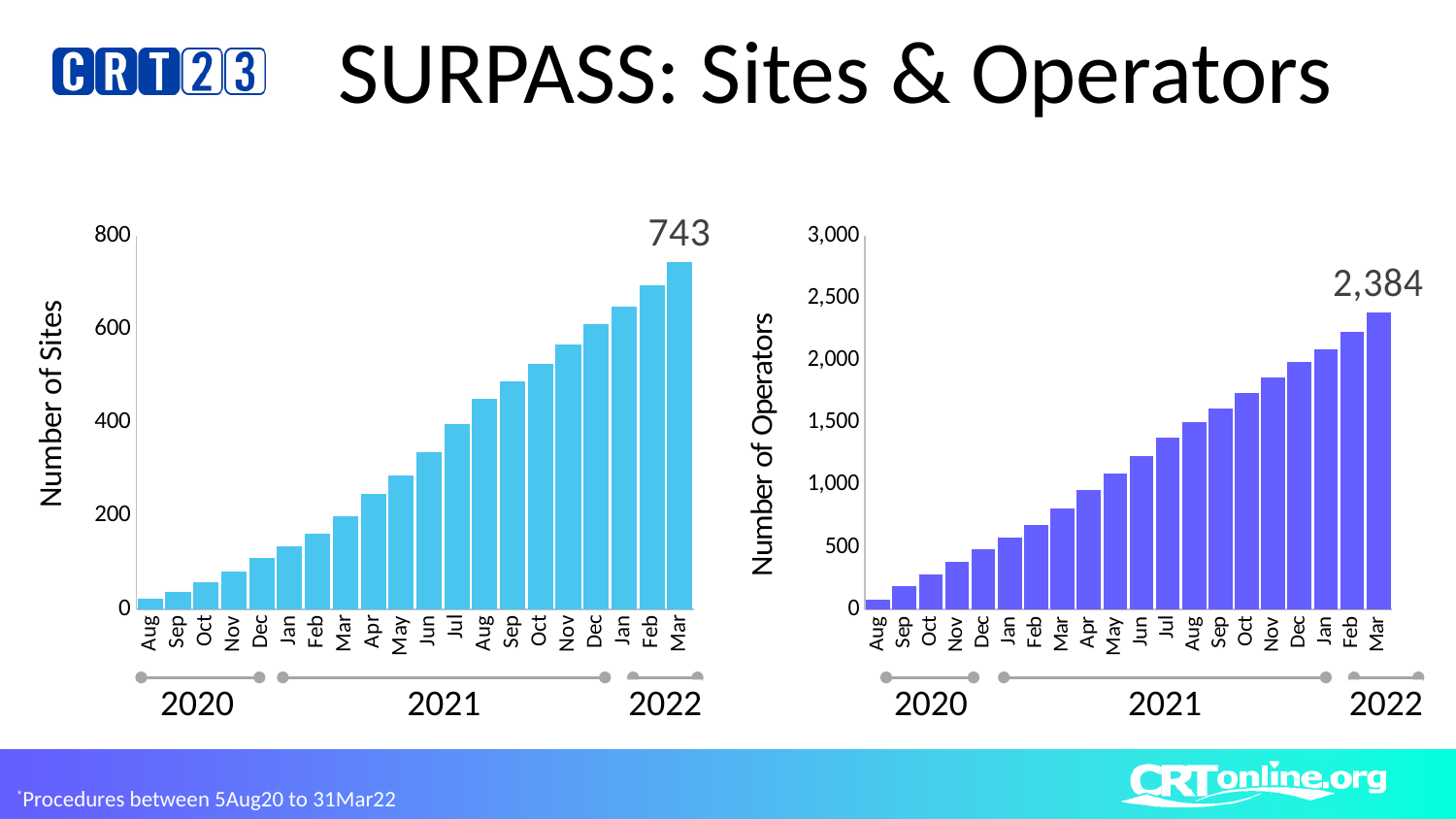
On the Number of Sites chart, what is the value for Mar 2022? 743 On the Number of Sites chart, is the value for Jan 2021 greater or less than 200? less On the Number of Sites chart, do the values rise or fall from Aug 2020 to Mar 2022? Rise On the Number of Sites chart, which month has the highest value? Mar 2022 On the Number of Sites chart, is the value for Aug 2021 greater or less than 400? greater What kind of chart is the Number of Operators chart? Bar chart On the Number of Operators chart, what is the value for Mar 2022? 2,384 On the Number of Operators chart, is the value for Feb 2022 greater or less than 2,000? greater On the Number of Operators chart, which month has the lowest value? Aug 2020 On the Number of Operators chart, which is larger, the value for Jun 2021 or the value for Dec 2020? Jun 2021 How many bars are plotted on the Number of Sites chart? 20